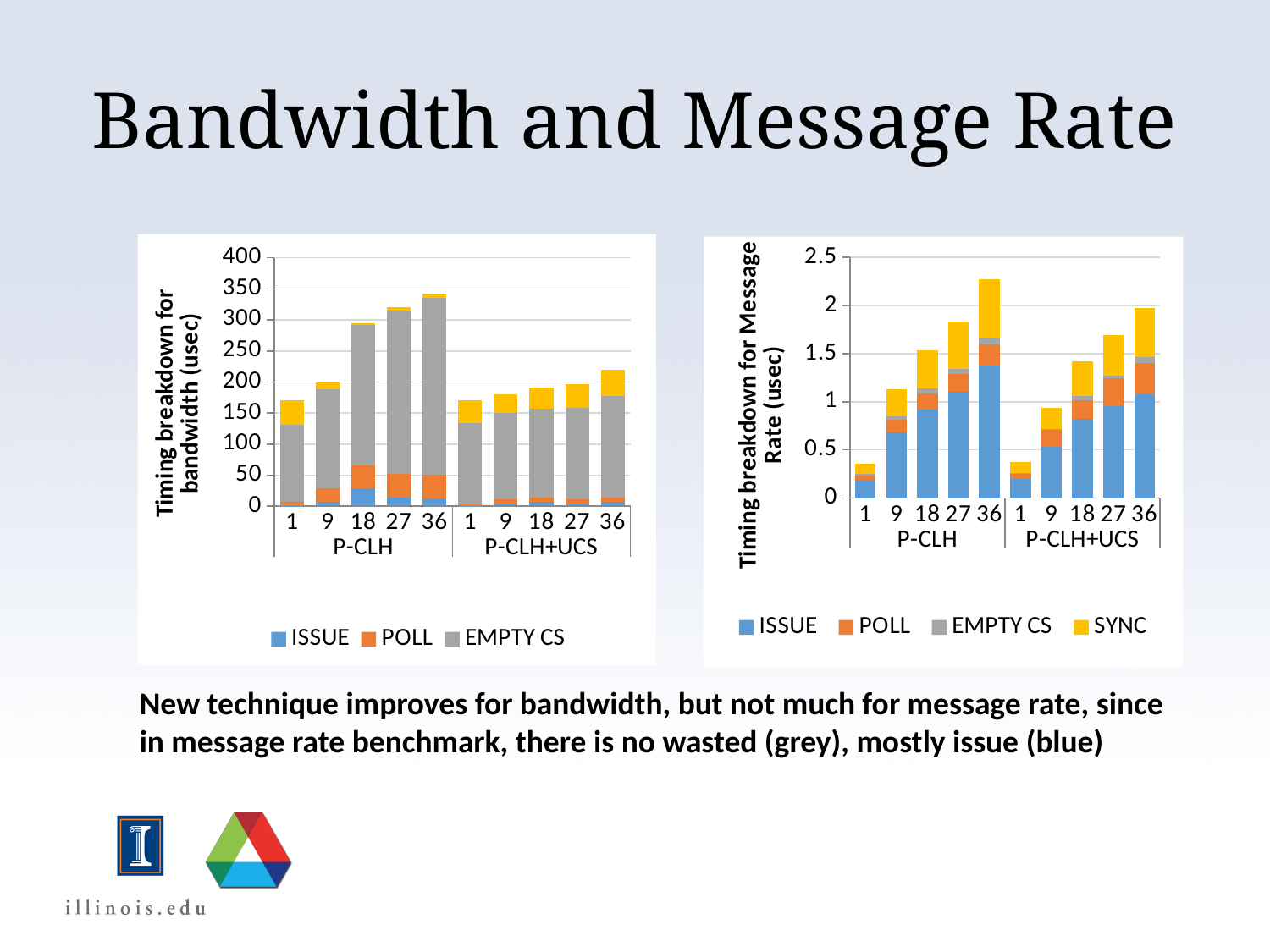
In the left chart (Timing breakdown for bandwidth), which has the larger total: P-CLH 27 or P-CLH+UCS 27? P-CLH 27 What is the y-axis title of the left chart? Timing breakdown for bandwidth (usec) In the right chart (Timing breakdown for Message Rate), which has the larger total: P-CLH 36 or P-CLH+UCS 36? P-CLH 36 How many series does the legend of the left chart (Timing breakdown for bandwidth) list? 3 How many series does the legend of the right chart (Timing breakdown for Message Rate) list? 4 In the right chart (Timing breakdown for Message Rate), is the total for P-CLH 27 greater or less than 1.5? greater In the right chart (Timing breakdown for Message Rate), which bar has the highest total? P-CLH 36 What kind of chart is the left chart (Timing breakdown for bandwidth)? Stacked bar chart In the left chart (Timing breakdown for bandwidth), is the total for P-CLH+UCS 36 greater or less than 250? less In the left chart (Timing breakdown for bandwidth), is the total for P-CLH 18 greater or less than 250? greater How many stacked bars are plotted in the left chart (Timing breakdown for bandwidth)? 10 In the left chart (Timing breakdown for bandwidth), which bar has the highest total? P-CLH 36